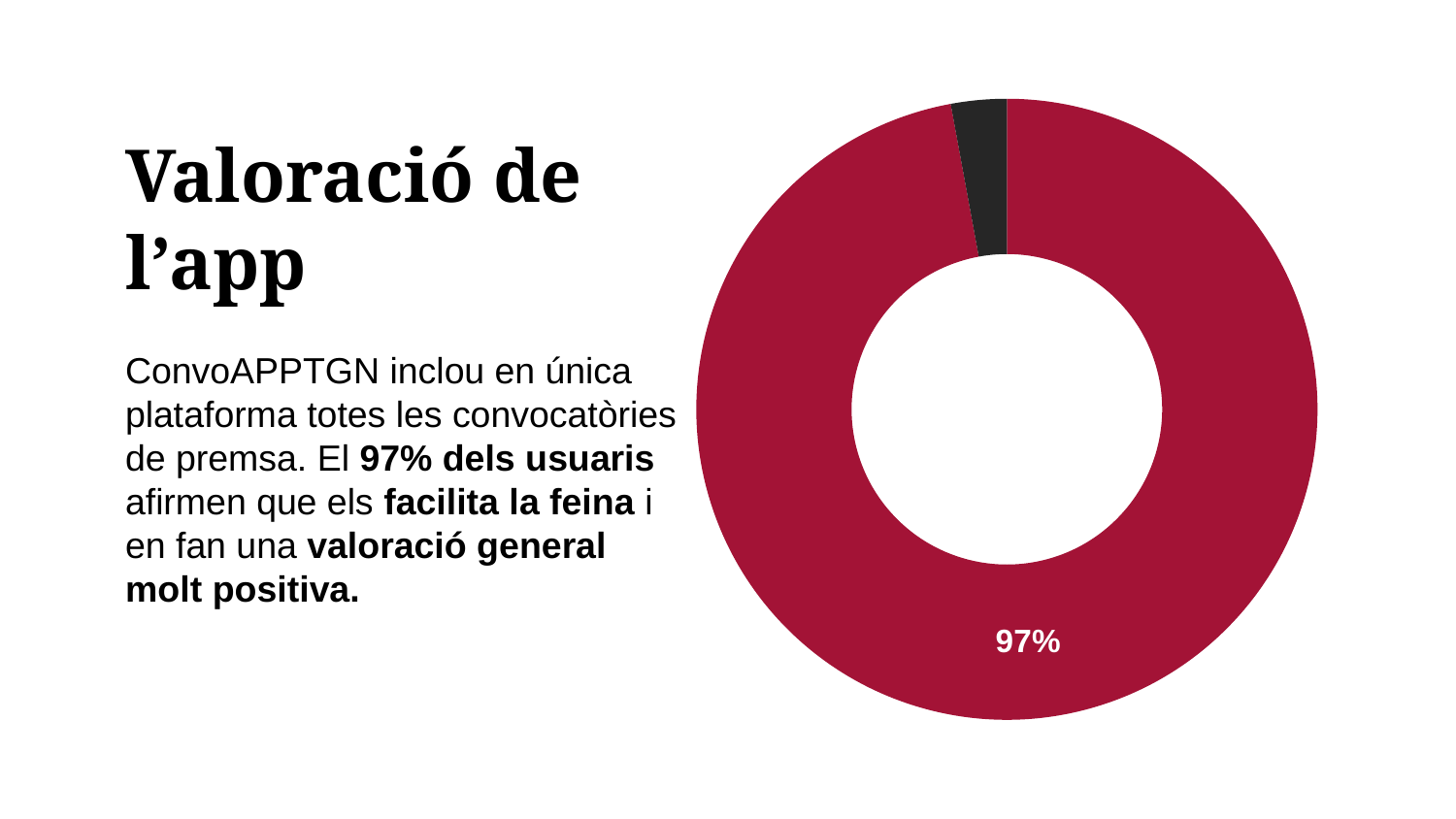
Is the labelled slice of the doughnut chart greater or less than 50%? greater Which slice of the doughnut chart is larger, the red one or the black one? The red one What colour is the slice labelled 97% in the doughnut chart? Red What is the title of the slide containing the doughnut chart? Valoració de l'app What value is printed on the large red slice of the doughnut chart? 97% What share of the doughnut chart does the labelled red slice represent? 97% How many slices does the doughnut chart have? 2 Which slice of the doughnut chart is the smallest? The black slice What kind of chart is shown on the slide? Doughnut (pie) chart